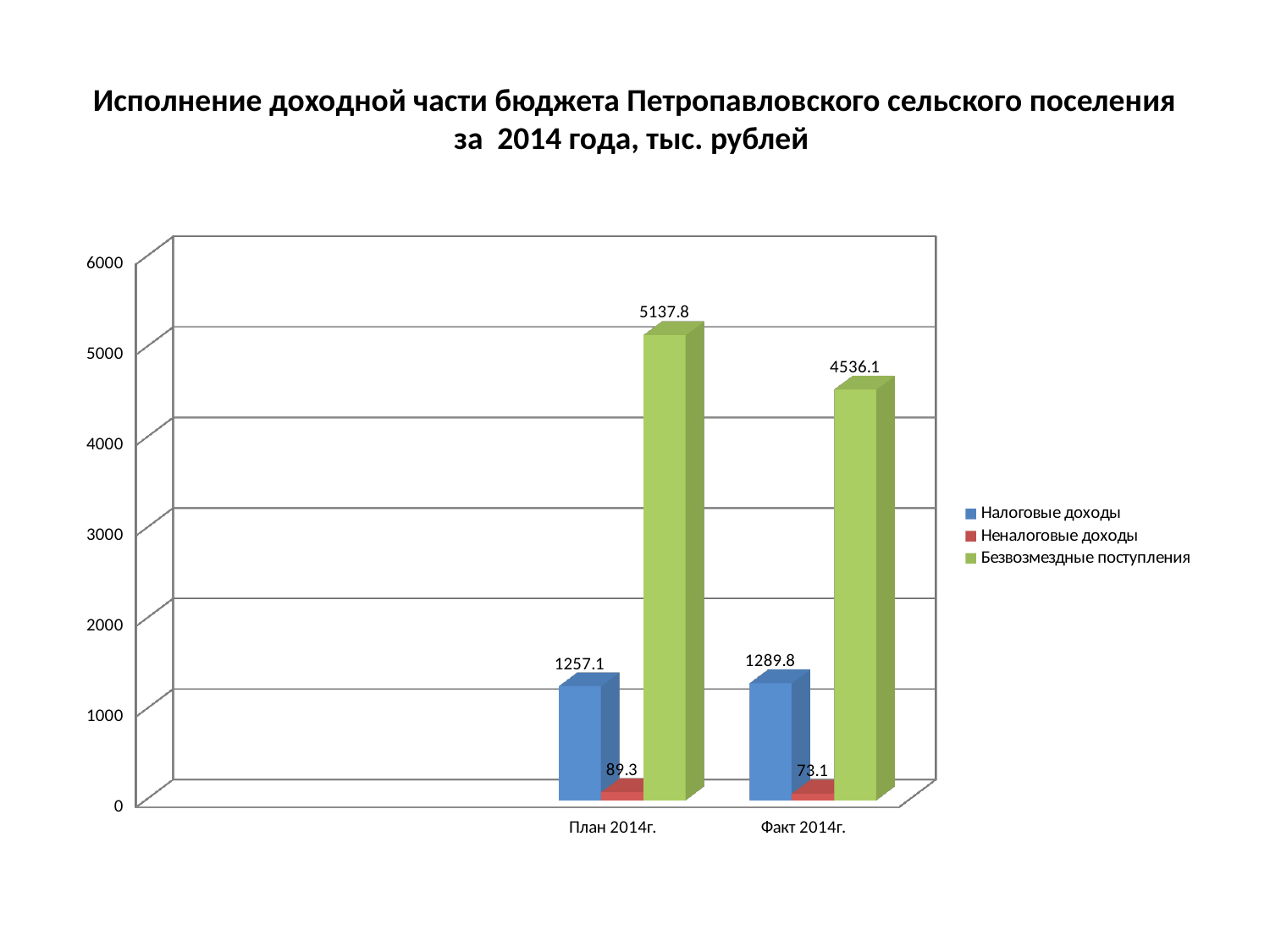
What is the value of Неналоговые доходы for План 2014г.? 89.3 What is the value of Неналоговые доходы for Факт 2014г.? 73.1 Which series has the highest value for План 2014г.? Безвозмездные поступления What is the difference between Налоговые доходы for Факт 2014г. and for План 2014г.? 32.7 How many series does the legend list? 3 What is the value of Налоговые доходы for План 2014г.? 1257.1 What is the value of Безвозмездные поступления for Факт 2014г.? 4536.1 What is the difference between Безвозмездные поступления for План 2014г. and for Факт 2014г.? 601.7 Which series has the lowest value for Факт 2014г.? Неналоговые доходы What kind of chart is shown on the slide? Bar chart Which is larger: Безвозмездные поступления for План 2014г. or for Факт 2014г.? План 2014г. How many categories are shown on the x axis? 2